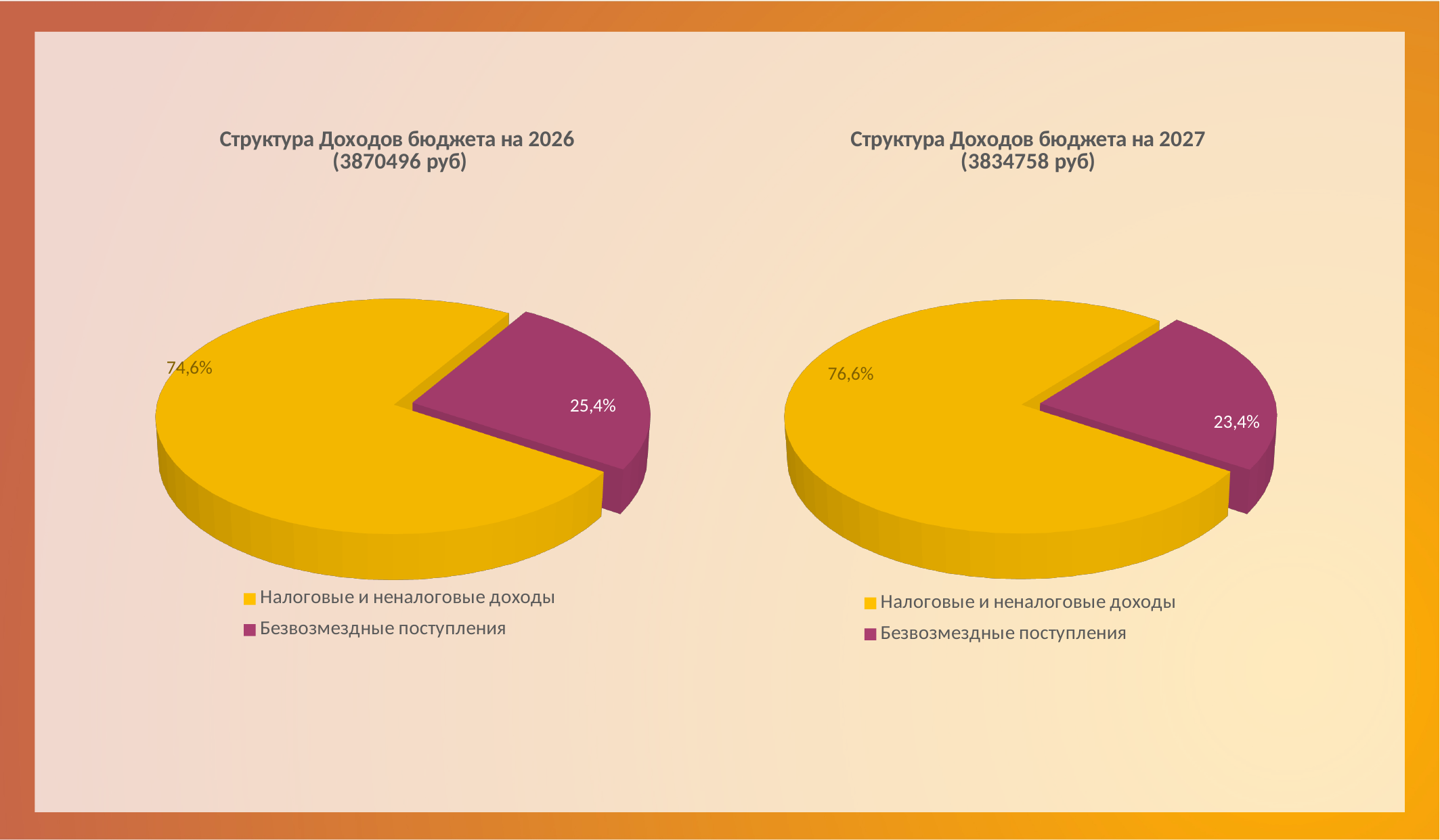
In the chart titled "Структура Доходов бюджета на 2027 (3834758 руб)", what share is labelled for Безвозмездные поступления? 23,4% In the left chart (2026), what is the difference in percentage points between Налоговые и неналоговые доходы and Безвозмездные поступления? 49,2 In the right chart (2027), what colour is the slice for Безвозмездные поступления? Purple In the chart titled "Структура Доходов бюджета на 2027 (3834758 руб)", what share is labelled for Налоговые и неналоговые доходы? 76,6% Is the share of Безвозмездные поступления larger in the 2026 chart or in the 2027 chart? 2026 In the right chart (2027), which category has the smallest slice? Безвозмездные поступления In the left chart (2026), which category has the largest slice? Налоговые и неналоговые доходы In the chart titled "Структура Доходов бюджета на 2026 (3870496 руб)", what share is labelled for Налоговые и неналоговые доходы? 74,6% In the chart titled "Структура Доходов бюджета на 2026 (3870496 руб)", what share is labelled for Безвозмездные поступления? 25,4% What type of chart is used on this slide? Pie chart How many entries does the legend of the left chart (2026) list? 2 How many slices does the chart titled "Структура Доходов бюджета на 2027 (3834758 руб)" have? 2